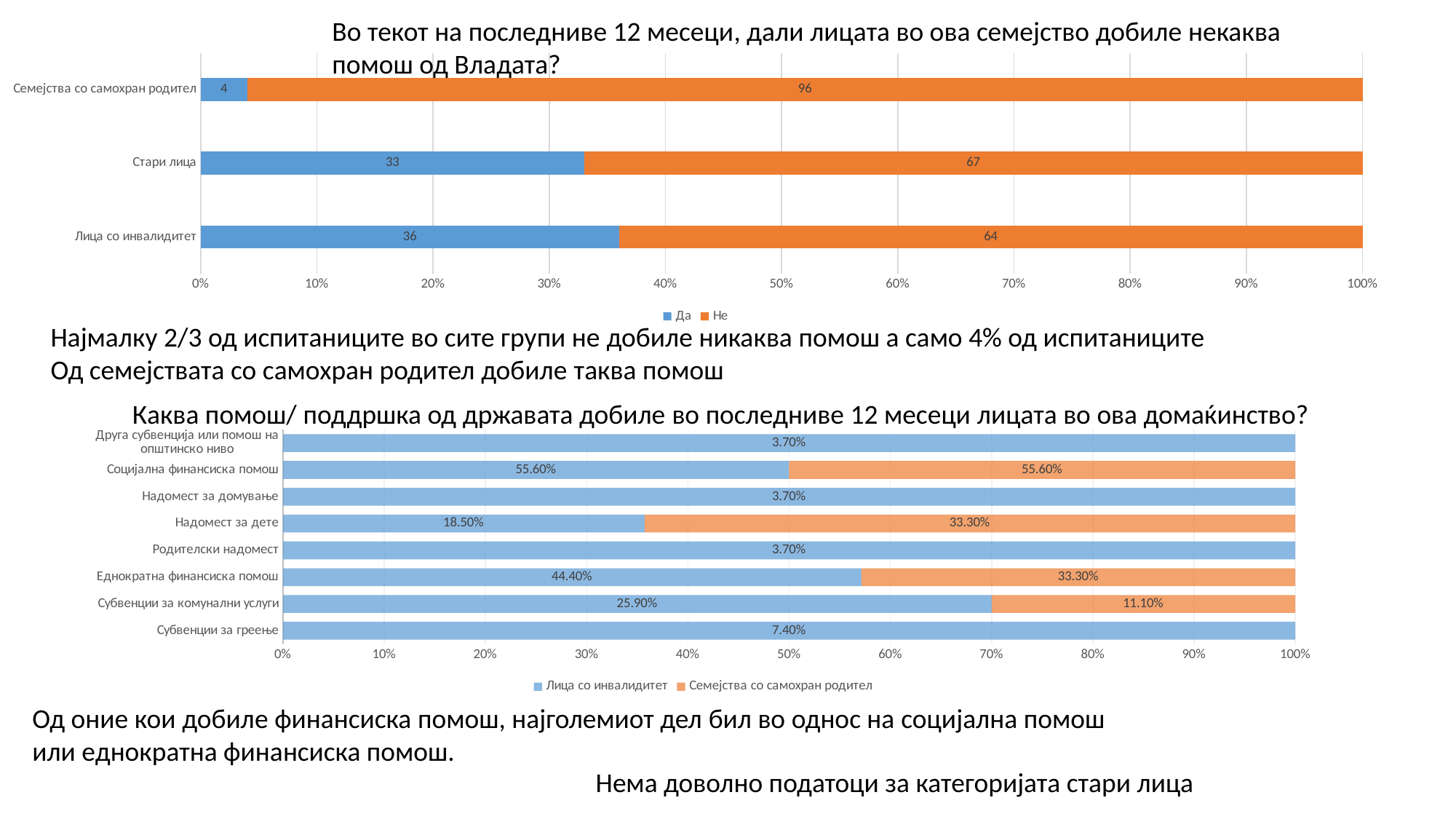
In the top chart, which category has the highest "Да" value? Лица со инвалидитет In the top chart ("Во текот на последниве 12 месеци..."), what is the value of "Да" for "Стари лица"? 33 In the top chart, what is the value of "Не" for "Семејства со самохран родител"? 96 In the bottom chart, which is larger for "Субвенции за комунални услуги": the value for "Лица со инвалидитет" or for "Семејства со самохран родител"? Лица со инвалидитет In the top chart, how many series does the legend list? 2 In the bottom chart, how many categories are shown on the vertical axis? 8 What type of chart is the top chart? Stacked bar chart In the top chart, what is the difference between the "Не" values for "Стари лица" and "Лица со инвалидитет"? 3 In the top chart, which category has the lowest "Да" value? Семејства со самохран родител In the bottom chart, what is the value for "Семејства со самохран родител" for "Надомест за дете"? 33.30% In the bottom chart, which series is shown in orange according to the legend? Семејства со самохран родител In the bottom chart ("Каква помош/ поддршка од државата..."), what is the value for "Лица со инвалидитет" for "Еднократна финансиска помош"? 44.40%